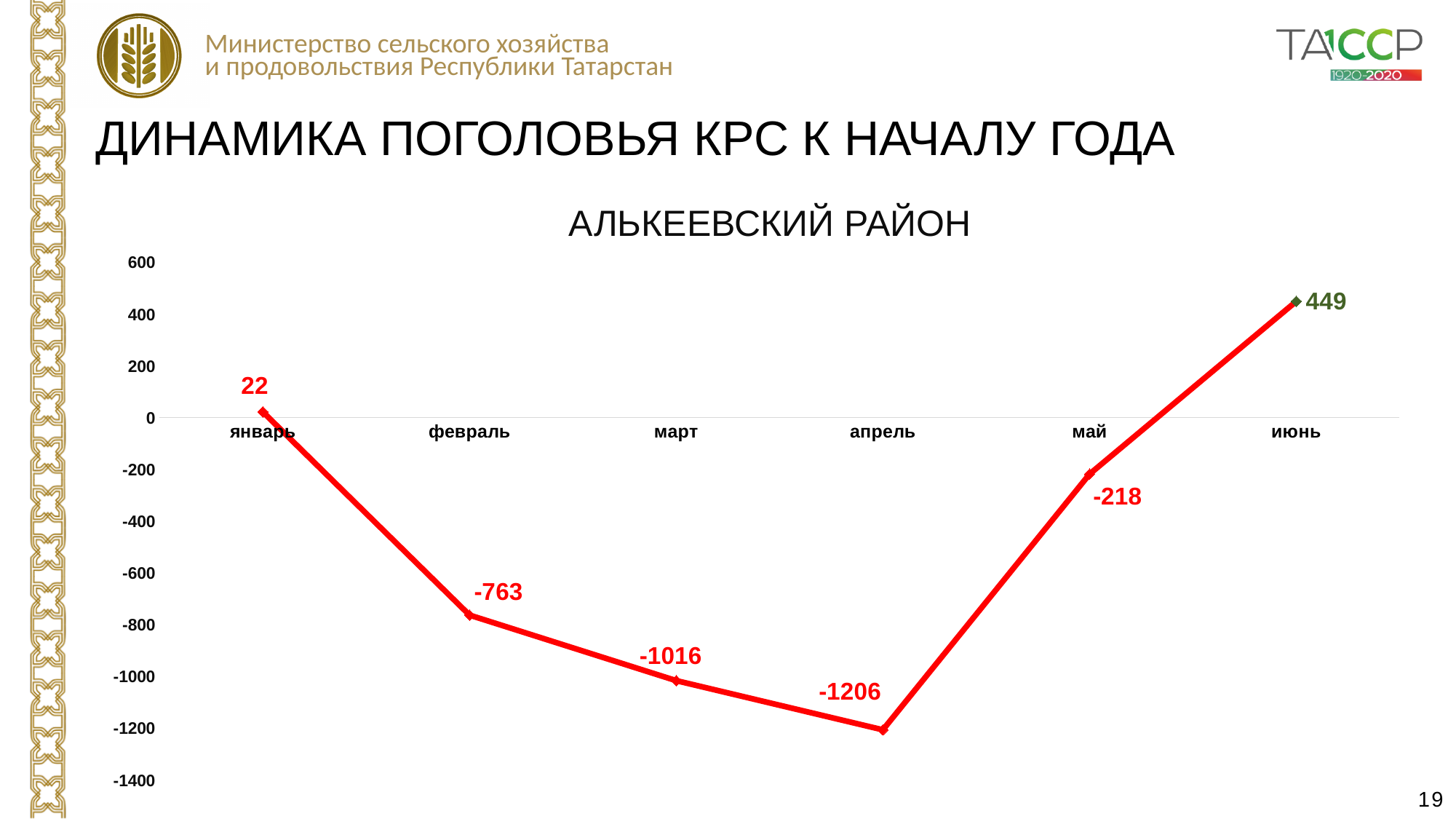
Which month has the lowest value? апрель How many months are plotted on the chart? 6 Do the values rise or fall from январь to апрель? fall What kind of chart is shown on the slide? line chart Which month has the highest value? июнь Which is larger, the value for февраль or the value for март? февраль What is the value for апрель? -1206 What is the value for июнь? 449 What is the value for май? -218 What is the value for январь? 22 What is the difference between the values for июнь and май? 667 What is the title of the chart? АЛЬКЕЕВСКИЙ РАЙОН